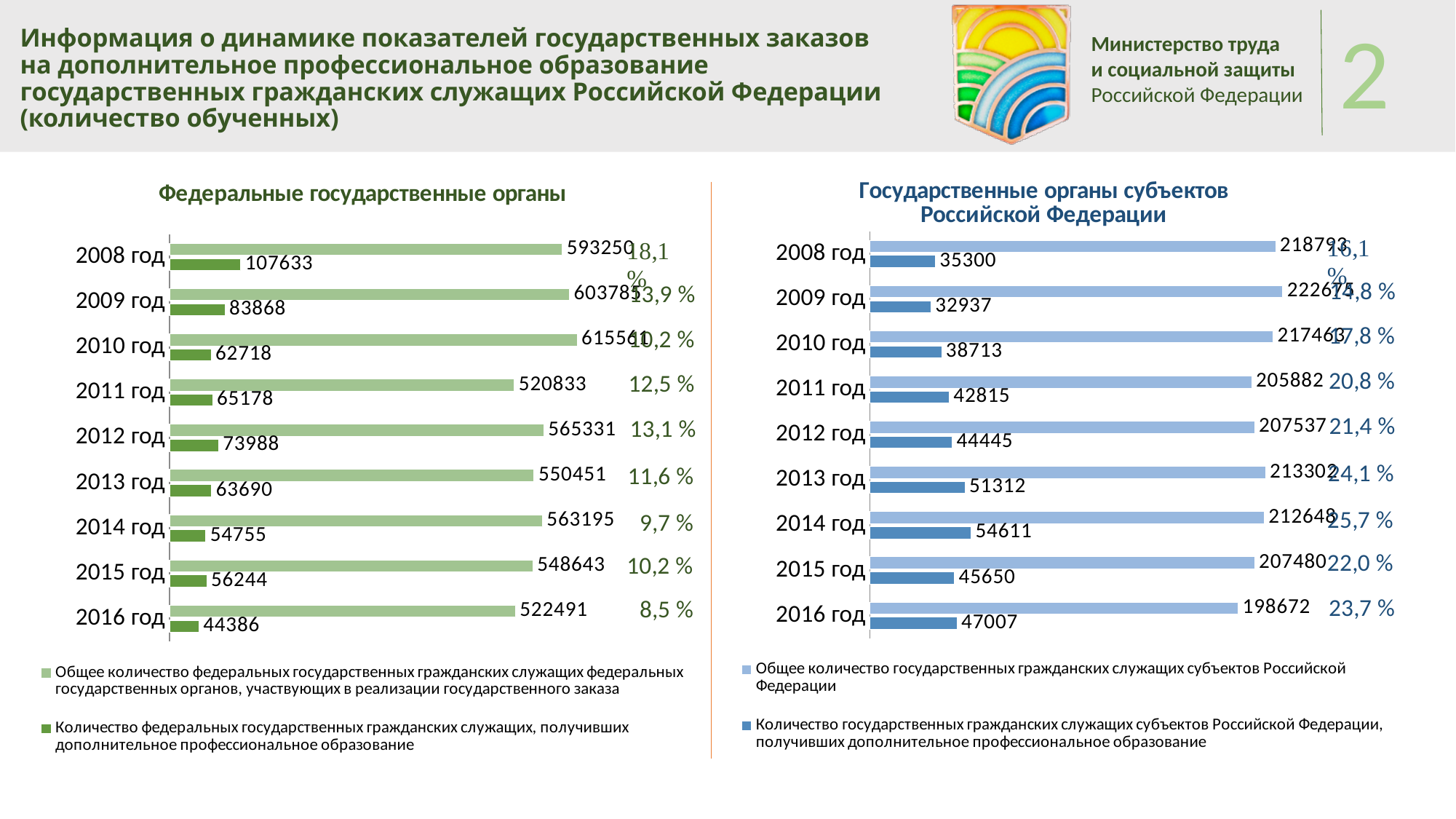
What type of chart is 'Государственные органы субъектов Российской Федерации'? bar chart In the chart 'Государственные органы субъектов Российской Федерации', what is the difference between the total number of civil servants and the number trained in 2016? 151665 In the chart 'Федеральные государственные органы', which year had more civil servants trained: 2012 or 2013? 2012 год In the chart 'Государственные органы субъектов Российской Федерации', what is the total number of civil servants in 2011? 205882 How many years are shown in the chart 'Федеральные государственные органы'? 9 In the chart 'Государственные органы субъектов Российской Федерации', how many civil servants received additional professional education in 2014? 54611 In the chart 'Федеральные государственные органы', which year has the highest number of civil servants who received additional professional education? 2008 год In the chart 'Федеральные государственные органы', what is the difference between the total number of civil servants and the number trained in 2008? 485617 In the chart 'Федеральные государственные органы', how many federal civil servants received additional professional education in 2008? 107633 In the chart 'Федеральные государственные органы', what is the total number of federal civil servants participating in the state order in 2016? 522491 In the chart 'Федеральные государственные органы', which year has the lowest number of civil servants who received additional professional education? 2016 год In the chart 'Государственные органы субъектов Российской Федерации', which year has the lowest number of civil servants who received additional professional education? 2009 год